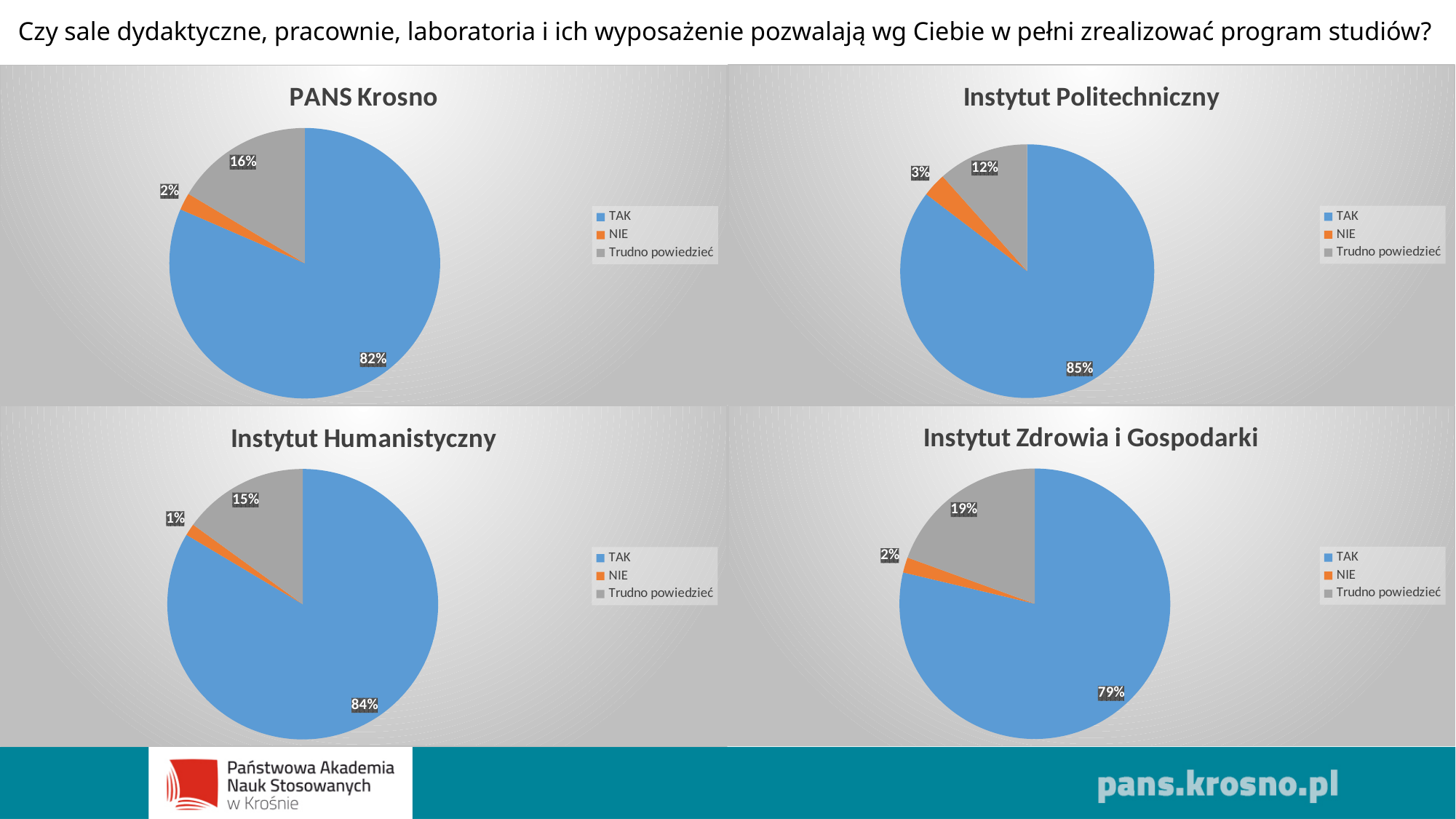
In the 'PANS Krosno' chart, what percentage is shown for TAK? 82% In the 'Instytut Humanistyczny' chart, what percentage is shown for Trudno powiedzieć? 15% In the 'Instytut Zdrowia i Gospodarki' chart, what percentage is shown for TAK? 79% How many entries does the legend of the 'PANS Krosno' chart list? 3 In the 'Instytut Humanistyczny' chart, which category has the smallest slice? NIE How many slices does the 'Instytut Politechniczny' pie chart have? 3 What type of chart is the 'Instytut Humanistyczny' chart? Pie chart In the 'Instytut Politechniczny' chart, what percentage is shown for NIE? 3% In the 'Instytut Zdrowia i Gospodarki' chart, what colour is the NIE slice? Orange Which is larger: the Trudno powiedzieć share in the 'Instytut Politechniczny' chart or in the 'Instytut Zdrowia i Gospodarki' chart? Instytut Zdrowia i Gospodarki In the 'Instytut Zdrowia i Gospodarki' chart, which category has the largest slice? TAK In the 'PANS Krosno' chart, what is the difference between the TAK and Trudno powiedzieć percentages? 66%